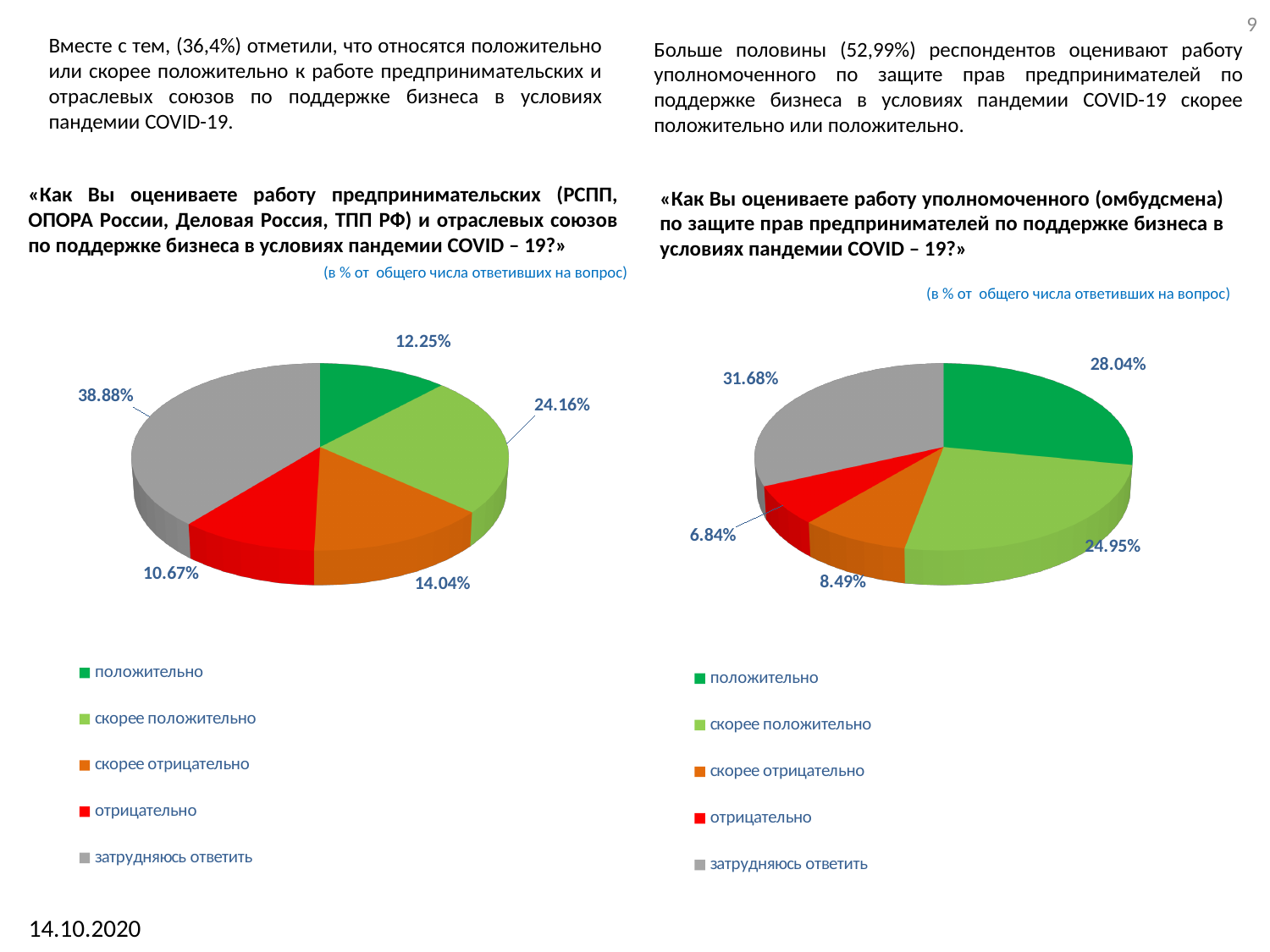
In the right pie chart (about the ombudsman), what is the difference between the shares for "затрудняюсь ответить" and "положительно"? 3.64% In the right pie chart (about the ombudsman), what share of respondents answered "положительно"? 28.04% In the right pie chart (about the ombudsman), what share of respondents answered "отрицательно"? 6.84% How many slices does the left pie chart (about business and industry unions) have? 5 In the left pie chart (about business and industry unions), which answer option has the largest share? затрудняюсь ответить In the left pie chart (about business and industry unions), what share of respondents answered "положительно"? 12.25% What type of chart is used on the right side of the slide (about the ombudsman)? pie chart In the right pie chart (about the ombudsman), which answer option has the smallest share? отрицательно In the left pie chart (about business and industry unions), what share of respondents answered "затрудняюсь ответить"? 38.88% In the right pie chart (about the ombudsman), which colour represents "затрудняюсь ответить"? grey In the left pie chart (about business and industry unions), what is the difference between the shares for "скорее положительно" and "положительно"? 11.91% Which is larger: the share for "положительно" in the left pie chart or the share for "положительно" in the right pie chart? the right pie chart (28.04%)